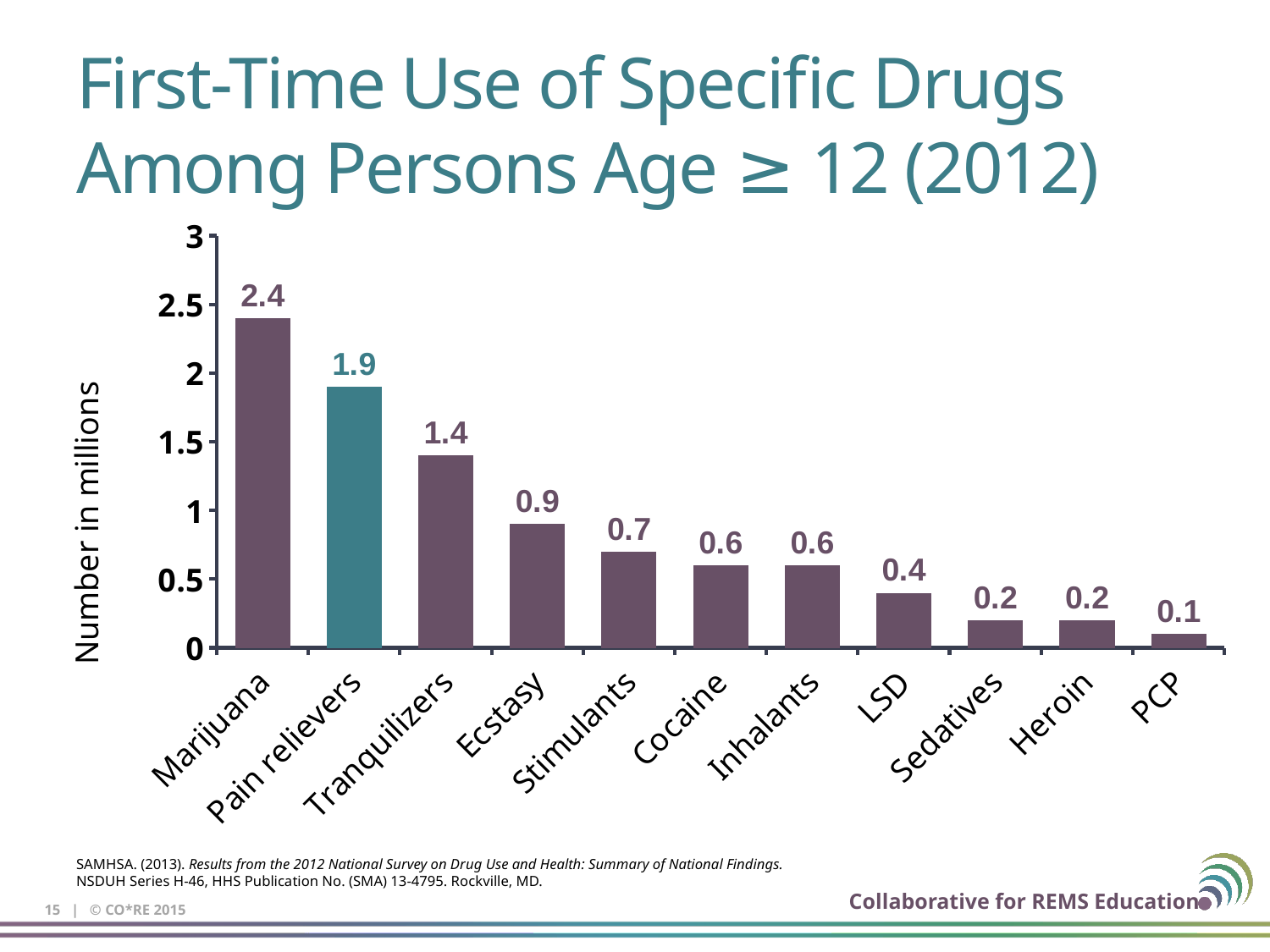
Which category has the highest value? Marijuana How many categories are shown on the x axis? 11 Is the value for Tranquilizers greater or less than 1? greater What is the value for Pain relievers? 1.9 Which is larger, the value for Ecstasy or the value for Stimulants? Ecstasy What is the value for LSD? 0.4 What is the difference between the values for Marijuana and Pain relievers? 0.5 Which category has the lowest value? PCP What kind of chart is shown on the slide? bar chart What is the value for Marijuana? 2.4 Which bar is shown in a different colour (teal) from the others? Pain relievers What is the value for Tranquilizers? 1.4